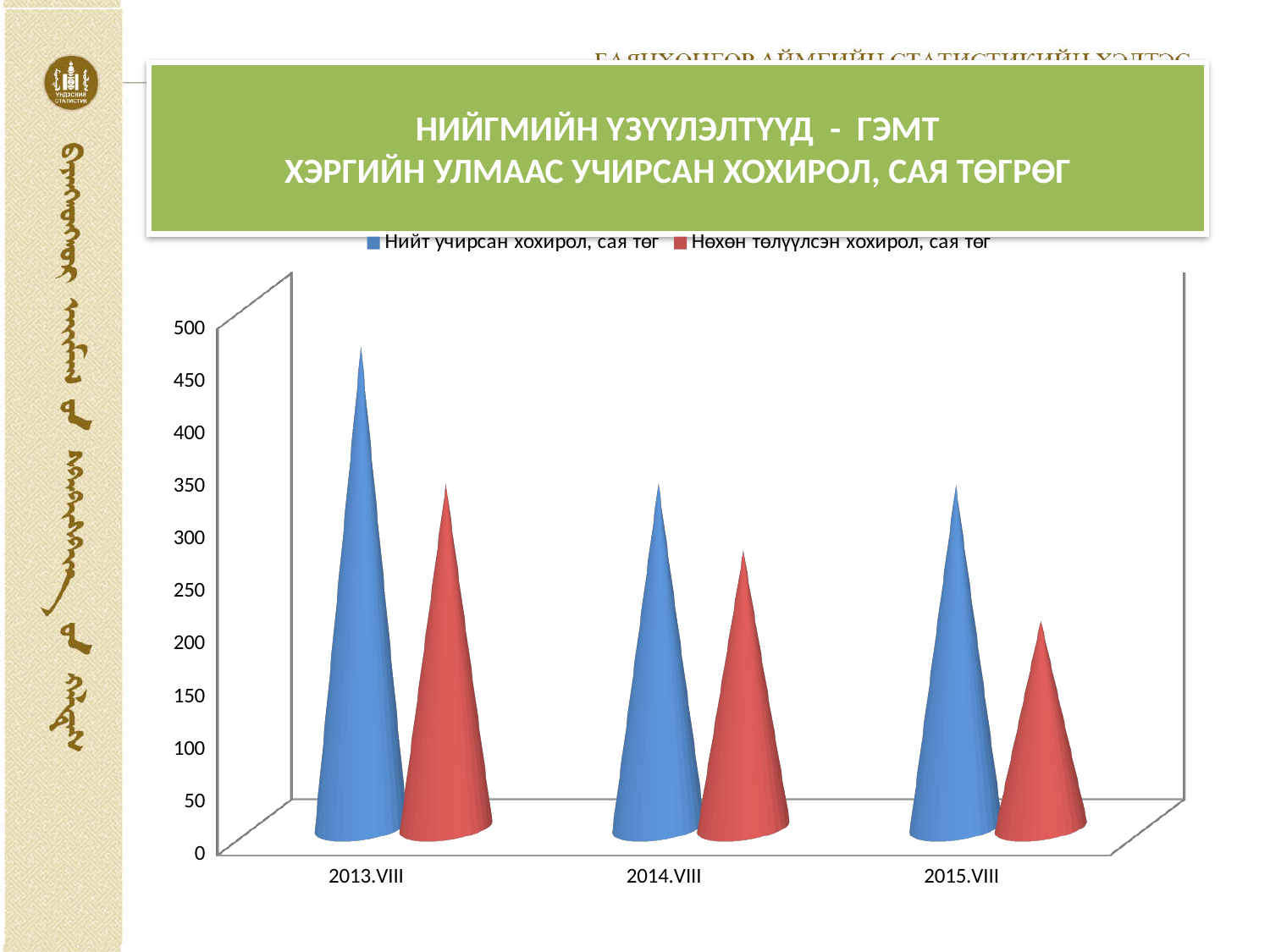
In 2013.VIII, which is larger: Нийт учирсан хохирол or Нөхөн төлүүлсэн хохирол? Нийт учирсан хохирол, сая төг Is the value for Нөхөн төлүүлсэн хохирол, сая төг in 2013.VIII greater or less than 250? greater Is the value for Нийт учирсан хохирол, сая төг in 2014.VIII greater or less than 300? greater Which colour represents Нөхөн төлүүлсэн хохирол, сая төг in the legend? red Which category has the lowest value for Нөхөн төлүүлсэн хохирол, сая төг? 2015.VIII How many series does the legend list? 2 Do the values for Нөхөн төлүүлсэн хохирол, сая төг rise or fall from 2013.VIII to 2015.VIII? fall Is the value for Нөхөн төлүүлсэн хохирол, сая төг in 2015.VIII greater or less than 250? less Which category has the highest value for Нийт учирсан хохирол, сая төг? 2013.VIII What kind of chart is shown on the slide? bar chart How many categories are shown on the x axis? 3